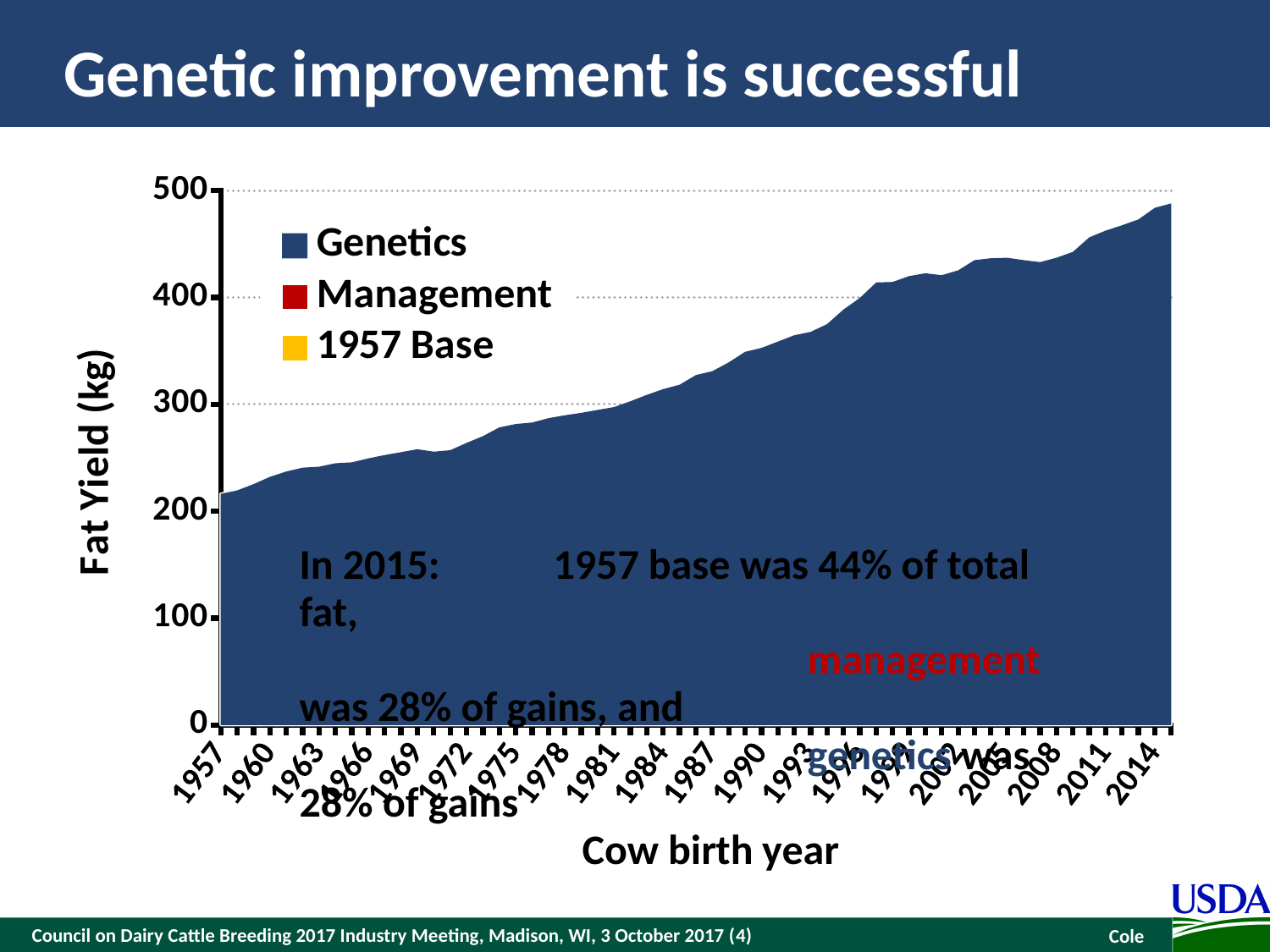
Does fat yield rise or fall as cow birth year increases? Rises Which cow birth year has the lowest fat yield? 1957 Is the fat yield for cows born in 1975 greater or less than 300? less What kind of chart is shown on the slide? Area chart Which is larger, the fat yield for cows born in 1990 or for cows born in 1969? 1990 Is the fat yield for cows born in 1957 greater or less than 200? greater Is the fat yield for cows born in 2014 greater or less than 400? greater How many series does the legend list? 3 What is the title of the x axis? Cow birth year What is the title of the y axis? Fat Yield (kg)